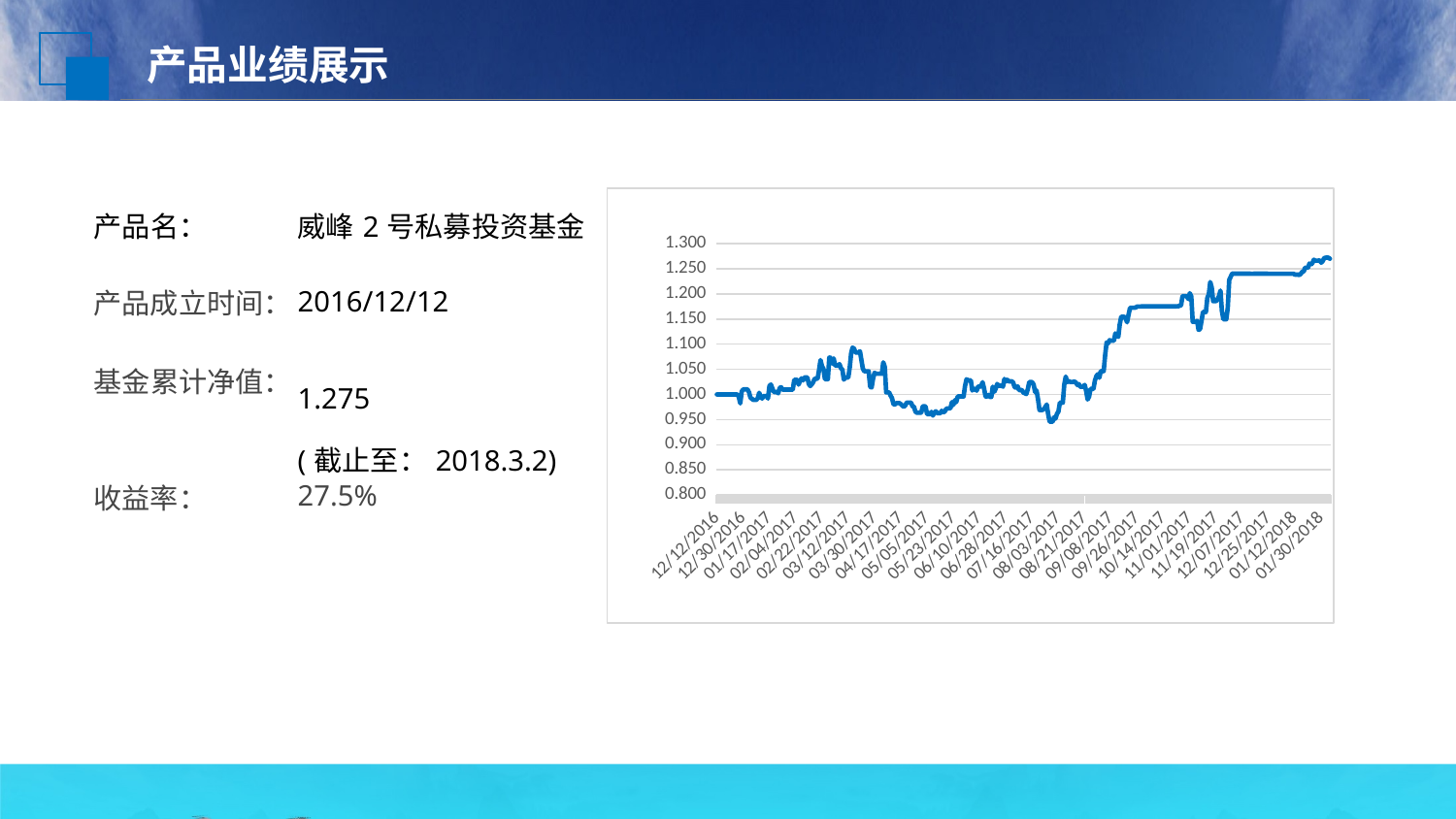
What is the last date label on the x axis? 01/30/2018 What is the highest tick value shown on the y axis? 1.300 Overall, does the line rise or fall from the start of the period to the end? rise Is the value of the line at 01/30/2018 greater or less than 1.250? greater Is the value of the line around 05/23/2017 greater or less than 1.000? less Is the value of the line higher at 01/30/2018 or at 08/21/2017? 01/30/2018 Is the value of the line around 03/12/2017 greater or less than 1.000? greater What is the value of the line at the first date, 12/12/2016? 1.000 What kind of chart is shown on the slide? line chart How many date labels are shown on the x axis? 24